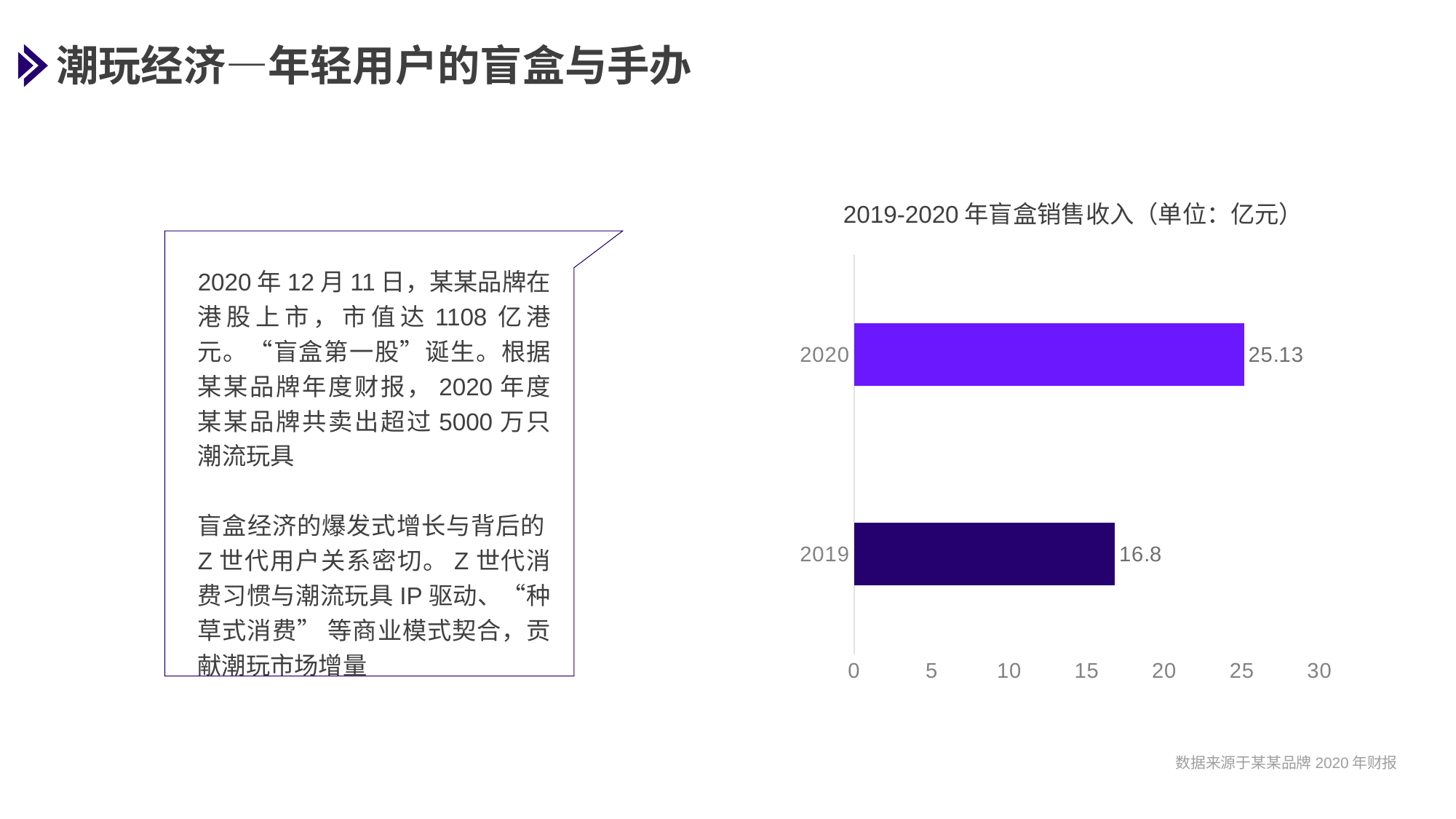
What kind of chart is shown on the slide? bar chart Does the blind box sales revenue rise or fall from 2019 to 2020? rise What is the blind box sales revenue for 2019? 16.8 Which year has the higher blind box sales revenue? 2020 Which year has the lower blind box sales revenue? 2019 What is the title of the chart? 2019-2020 年盲盒销售收入（单位：亿元） Is the value for 2020 greater or less than 25? greater What is the highest value shown on the horizontal axis of the chart? 30 What is the blind box sales revenue for 2020? 25.13 What is the difference between the 2020 and 2019 blind box sales revenue? 8.33 How many years are shown in the chart? 2 Is the value for 2019 greater or less than 20? less